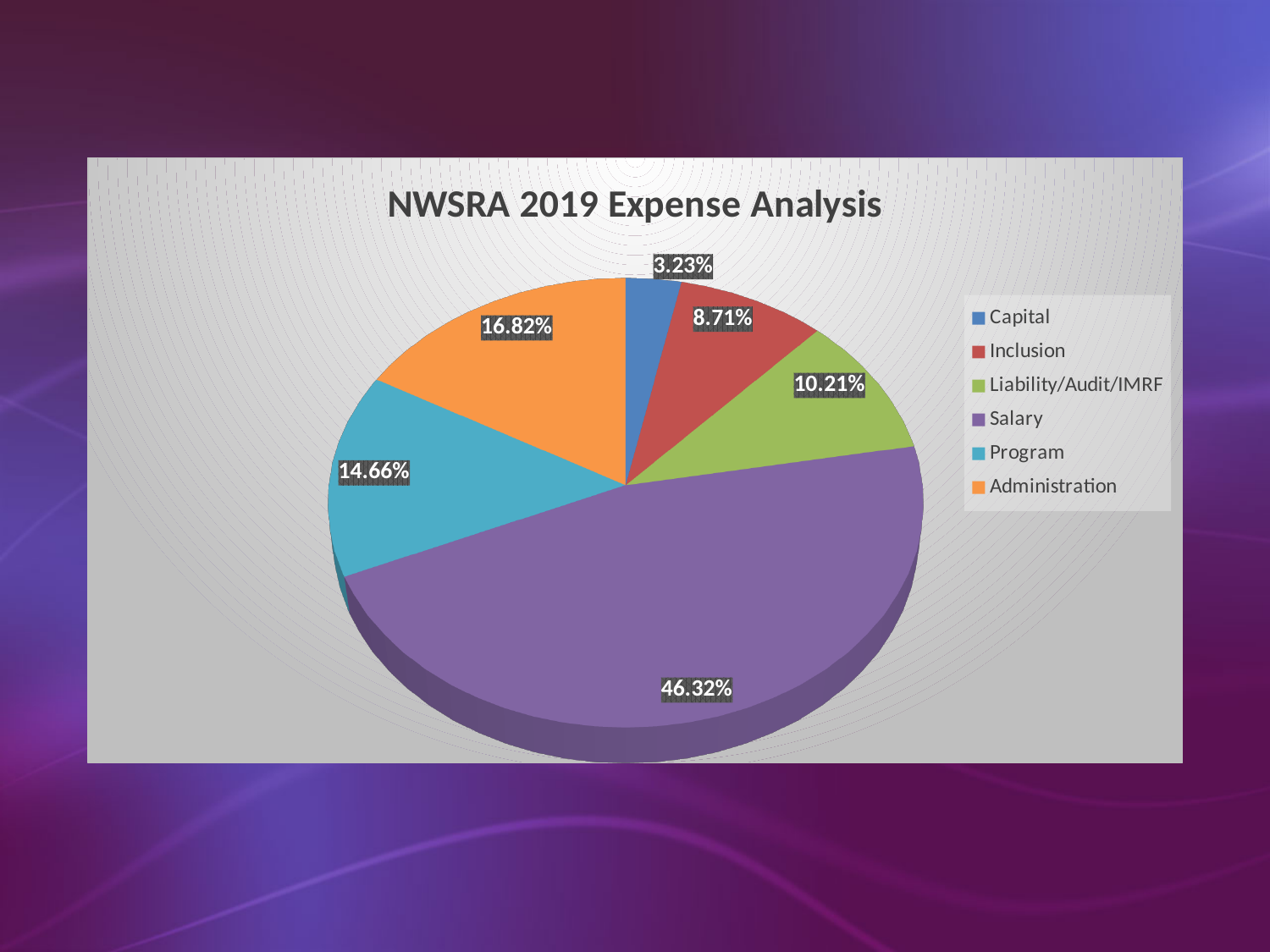
What is the value shown for Administration? 16.82% What kind of chart is shown on the slide? pie chart What is the title of the chart? NWSRA 2019 Expense Analysis What share of expenses does Salary account for? 46.32% What is the value shown for Capital? 3.23% What is the difference between the Administration and Program shares? 2.16% Which category has the largest slice of the pie? Salary Which is larger, Inclusion or Liability/Audit/IMRF? Liability/Audit/IMRF Which category has the smallest slice of the pie? Capital What is the value shown for Program? 14.66% What colour is the Salary slice? purple How many categories does the legend list? 6